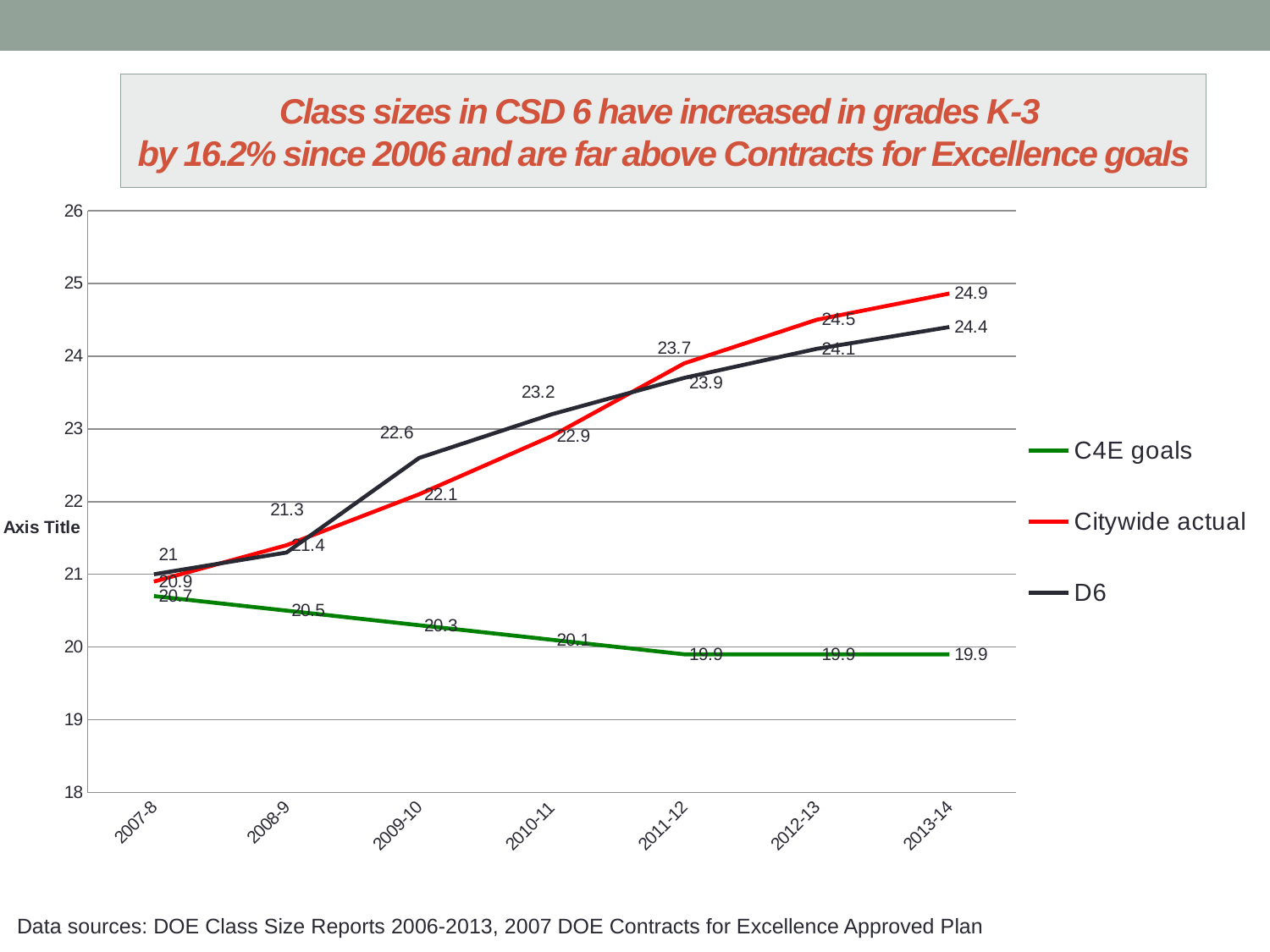
How many series does the legend list? 3 In 2009-10, which is larger: the D6 value or the Citywide actual value? D6 Is the Citywide actual value for 2012-13 greater or less than 24? greater What is the Citywide actual value for 2013-14? 24.9 What is the D6 value for 2013-14? 24.4 What is the D6 value for 2009-10? 22.6 What is the C4E goals value for 2013-14? 19.9 Do the C4E goals values rise or fall from 2007-8 to 2013-14? fall How many school years are plotted along the x axis? 7 What is the difference between the Citywide actual and D6 values in 2013-14? 0.5 In which year is the D6 value highest? 2013-14 What kind of chart is shown on the slide? line chart